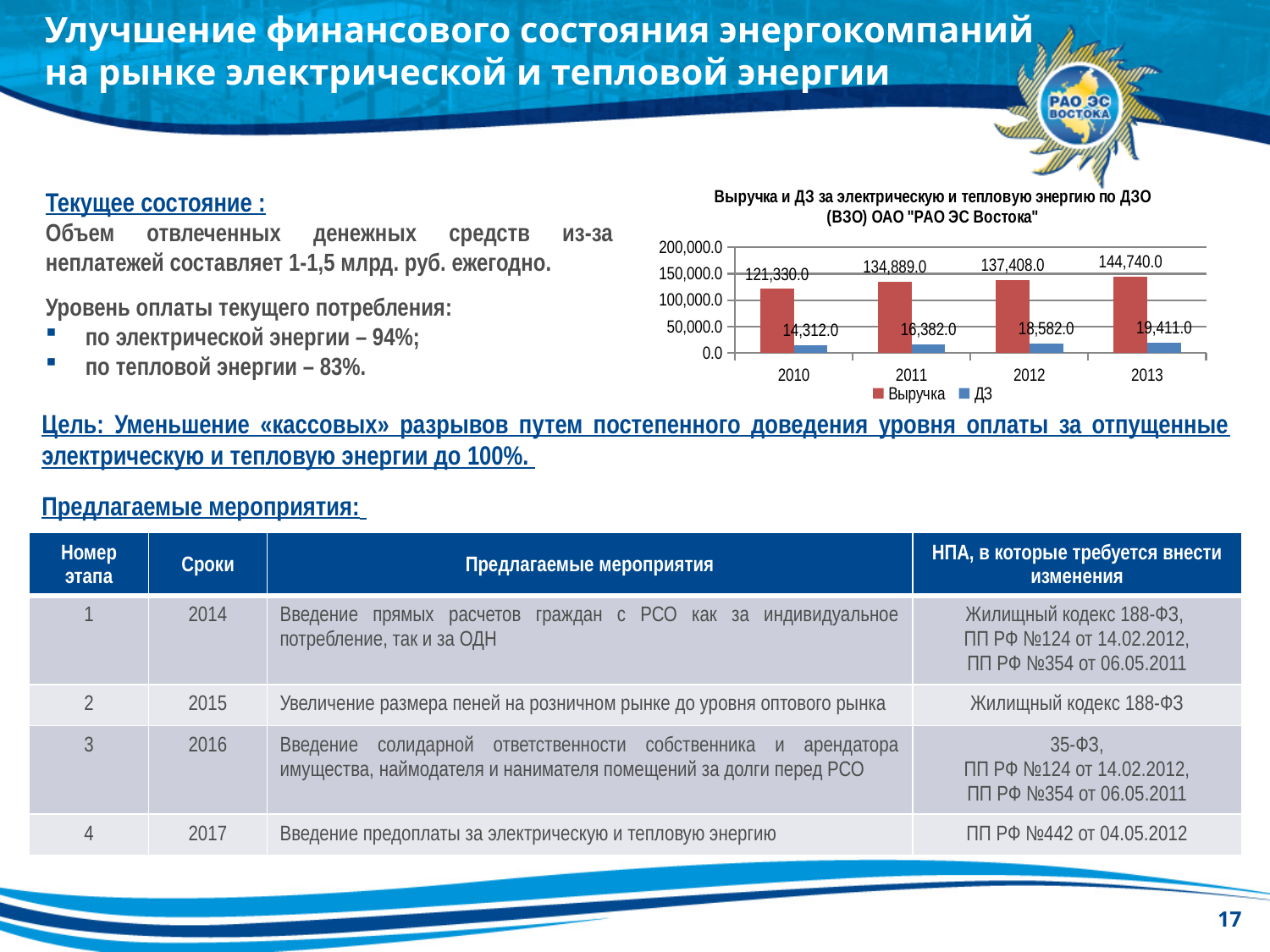
Что больше: выручка за 2011 год или выручка за 2012 год? Выручка за 2012 год В каком году выручка на диаграмме была наибольшей? 2013 На сколько ДЗ за 2012 год больше ДЗ за 2011 год? 2,200.0 На сколько выручка за 2013 год больше выручки за 2010 год? 23,410.0 Как изменяется выручка на диаграмме с 2010 по 2013 год? Растёт Какое значение выручки показано на диаграмме за 2010 год? 121,330.0 Какого типа диаграмма показана на слайде? Столбчатая (bar chart) В каком году ДЗ на диаграмме была наименьшей? 2010 Сколько рядов данных перечислено в легенде диаграммы? 2 Какое значение ДЗ показано на диаграмме за 2011 год? 16,382.0 Сколько лет (категорий) показано на диаграмме? 4 Какое значение ДЗ показано на диаграмме за 2013 год? 19,411.0